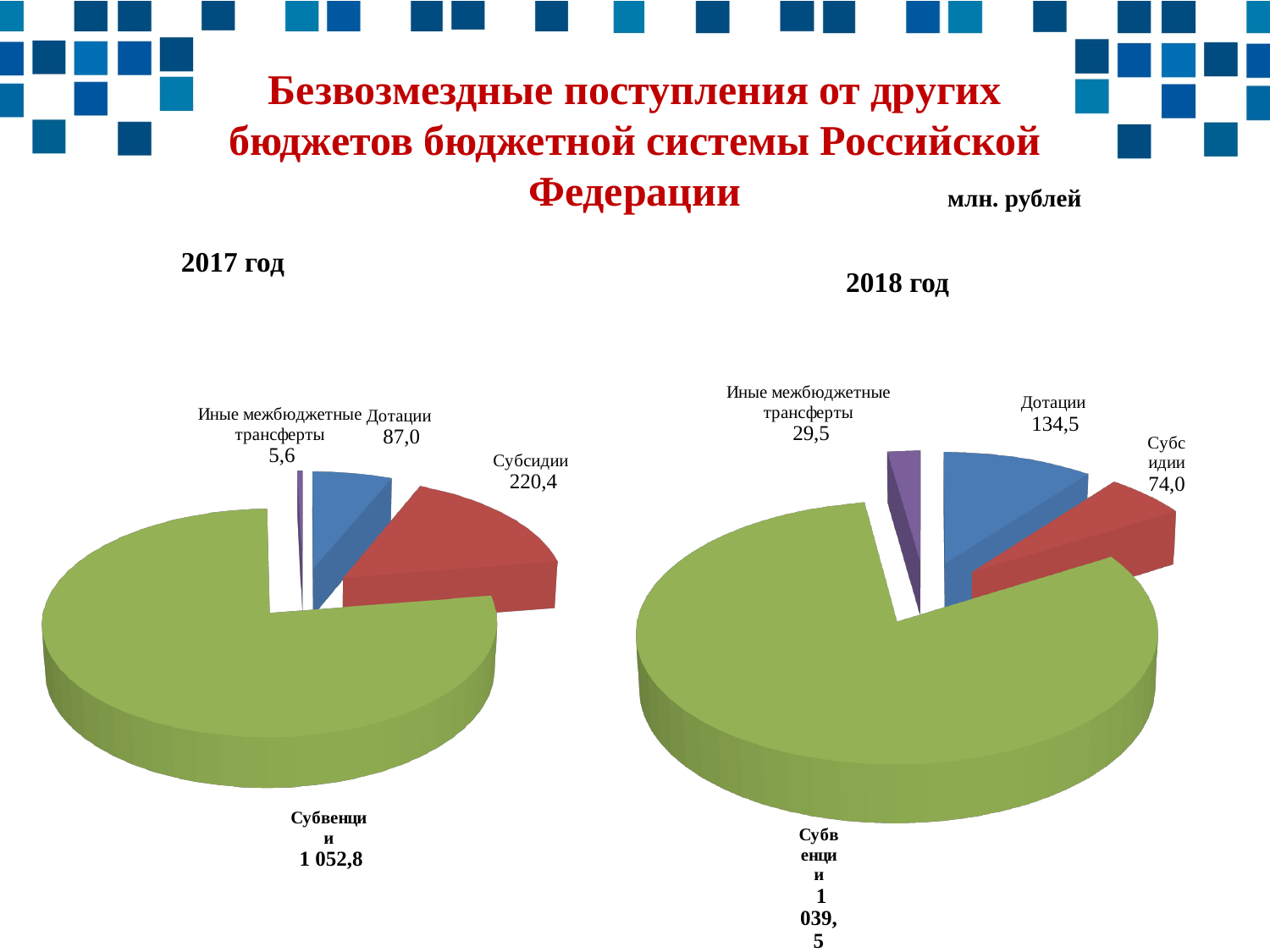
In the 2017 год chart, what is the difference between Субсидии and Дотации? 133,4 In the 2018 год chart, which is larger: Дотации or Субсидии? Дотации In the 2018 год chart, which category has the smallest value? Иные межбюджетные трансферты In the 2017 год chart, which category has the largest value? Субвенции What unit of measurement is stated on the slide for the charts? млн. рублей How many slices does the 2018 год pie chart have? 4 What is the difference between the Субвенции value in the 2017 год chart and in the 2018 год chart? 13,3 In the 2017 год chart, what is the value for Субсидии? 220,4 What type of chart is used for the 2017 год data? Pie chart In the 2018 год chart, what is the value for Субвенции? 1 039,5 In the 2018 год chart, what is the value for Дотации? 134,5 In the 2017 год chart, what is the value for Иные межбюджетные трансферты? 5,6